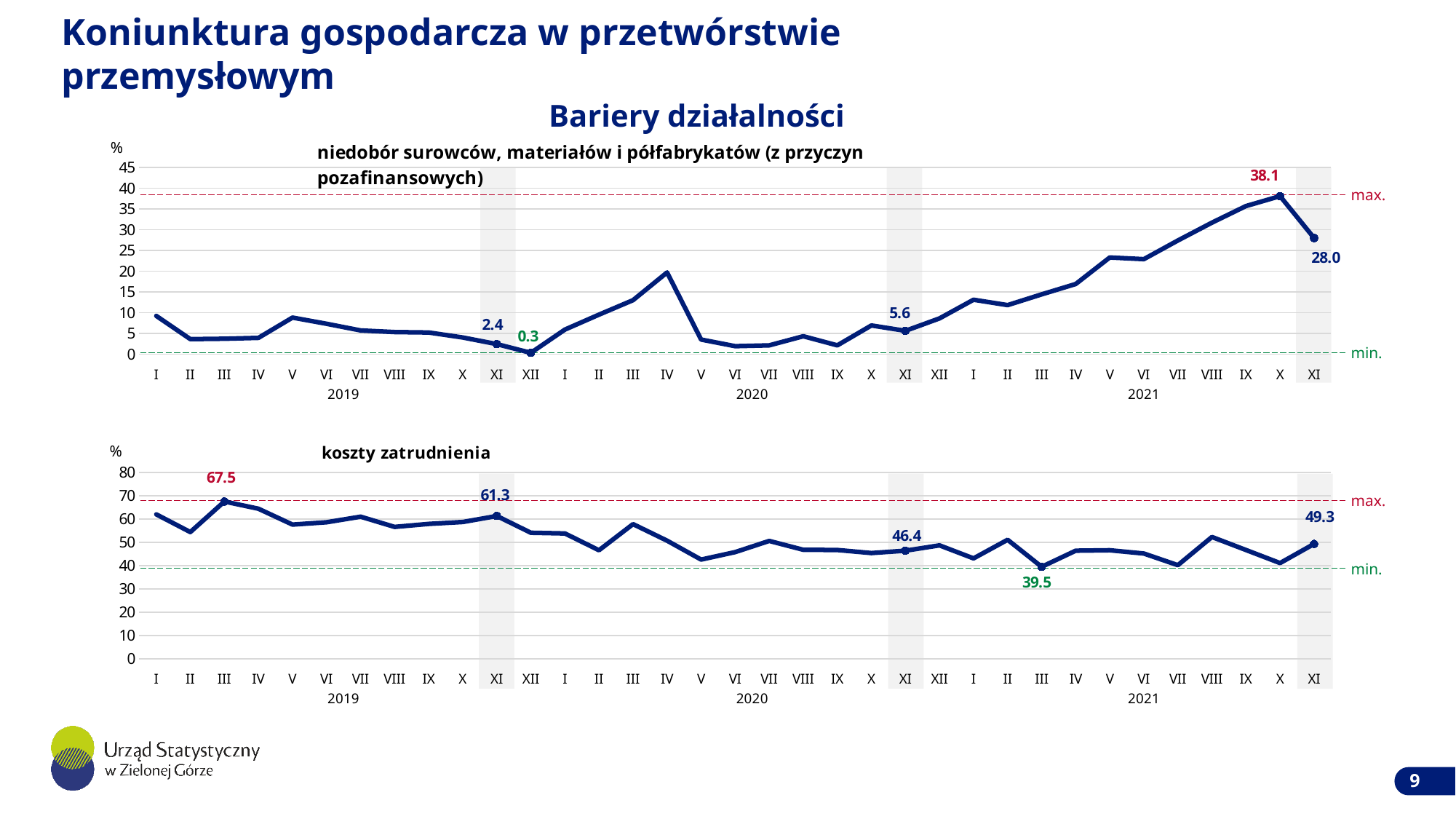
What kind of chart is the top chart (niedobór surowców, materiałów i półfabrykatów)? line chart In the top chart (niedobór surowców, materiałów i półfabrykatów), which month has the lowest value? XII 2019 In the bottom chart (koszty zatrudnienia), which month has the lowest value? III 2021 In the top chart (niedobór surowców, materiałów i półfabrykatów), do the values rise or fall from XI 2020 to X 2021? rise In the top chart (niedobór surowców, materiałów i półfabrykatów), is the value for IV 2020 greater or less than 15? greater In the top chart (niedobór surowców, materiałów i półfabrykatów), what is the difference between the values for X 2021 and XI 2021? 10.1 In the bottom chart (koszty zatrudnienia), what is the value for III 2019? 67.5 In the bottom chart (koszty zatrudnienia), what is the difference between the values for XI 2019 and XI 2020? 14.9 In the top chart (niedobór surowców, materiałów i półfabrykatów), what is the value for XI 2021? 28.0 In the bottom chart (koszty zatrudnienia), what is the value for XI 2020? 46.4 In the bottom chart (koszty zatrudnienia), which is larger: the value for XI 2019 or the value for XI 2021? XI 2019 In the top chart (niedobór surowców, materiałów i półfabrykatów), what is the value for X 2021? 38.1